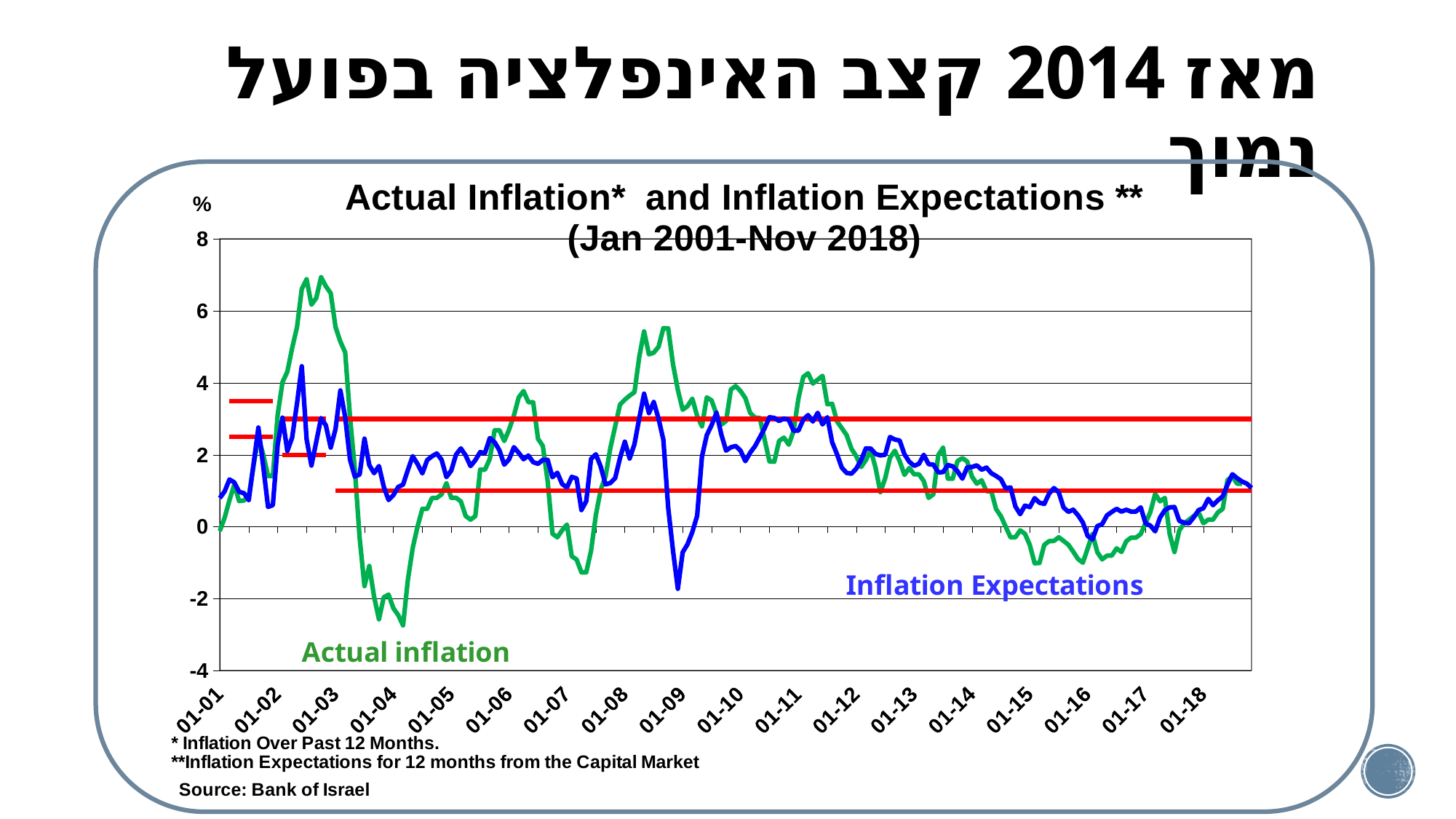
How many year labels are shown on the horizontal axis? 18 Is the value of Actual inflation around 01-08 greater or less than 4? less Is the value of Inflation Expectations at its dip around 01-09 greater or less than 0? less Is the peak value of Actual inflation around 01-03 greater or less than 6? greater Which series reaches a higher value around 01-03, Actual inflation or Inflation Expectations? Actual inflation Does Actual inflation generally rise or fall between 01-11 and 01-16? fall Which colour is used for the Actual inflation line? green What is the title of the chart? Actual Inflation* and Inflation Expectations ** (Jan 2001-Nov 2018) What kind of chart is shown on the slide? line chart How many data series are plotted in the chart (excluding the red reference lines)? 2 What is the highest value shown on the vertical axis? 8